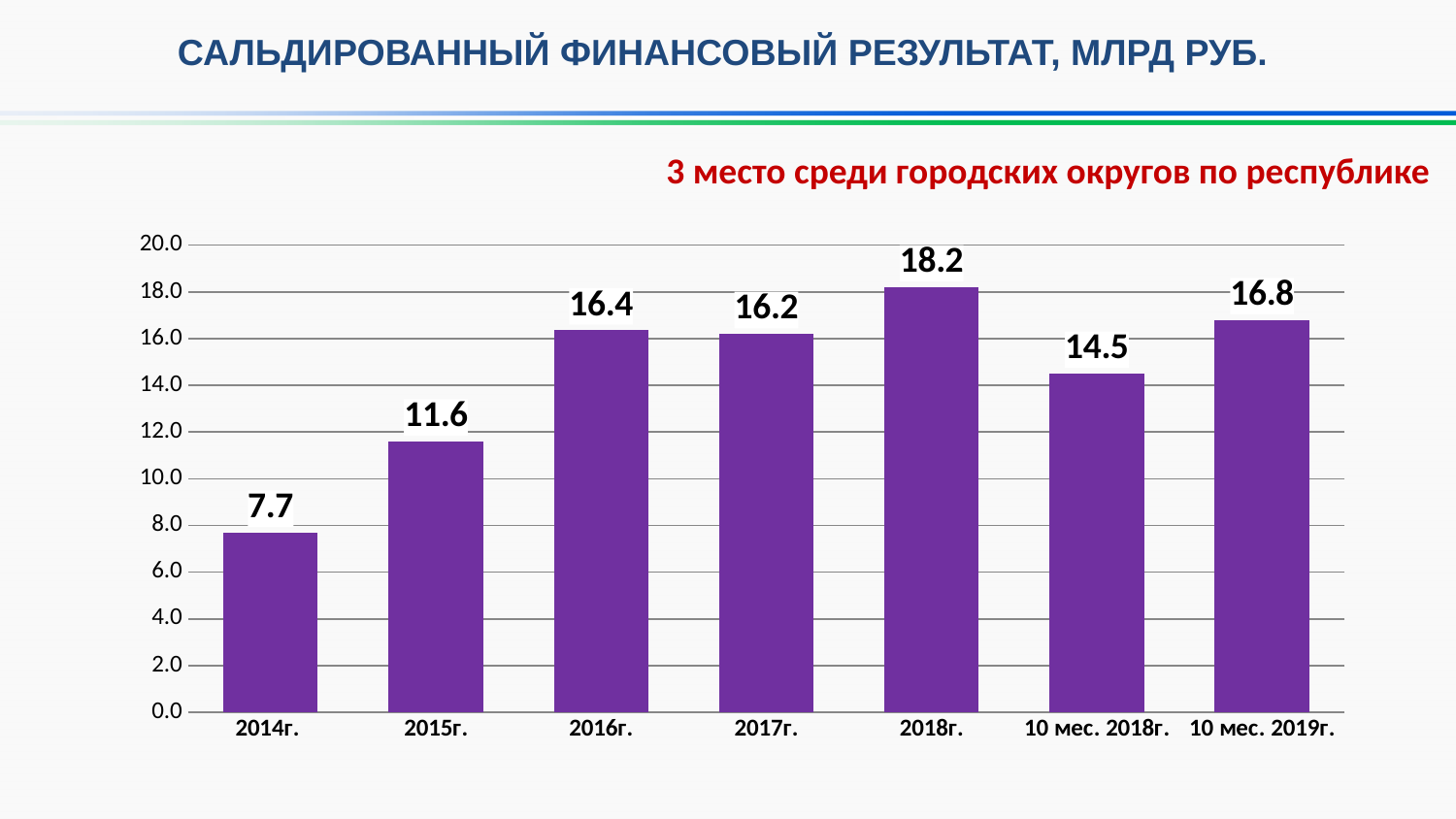
What kind of chart is shown on the slide? bar chart What is the title of the chart? САЛЬДИРОВАННЫЙ ФИНАНСОВЫЙ РЕЗУЛЬТАТ, МЛРД РУБ. Which category has the highest value? 2018г. What is the difference between the values for 10 мес. 2019г. and 10 мес. 2018г.? 2.3 Do the values rise or fall from 2014г. to 2016г.? rise Which is larger, the value for 2016г. or the value for 2017г.? 2016г. How many categories are shown on the x axis? 7 What is the value for 10 мес. 2019г.? 16.8 Which category has the lowest value? 2014г. What is the value for 2014г.? 7.7 What is the value for 2018г.? 18.2 Is the value for 2015г. greater or less than 10.0? greater